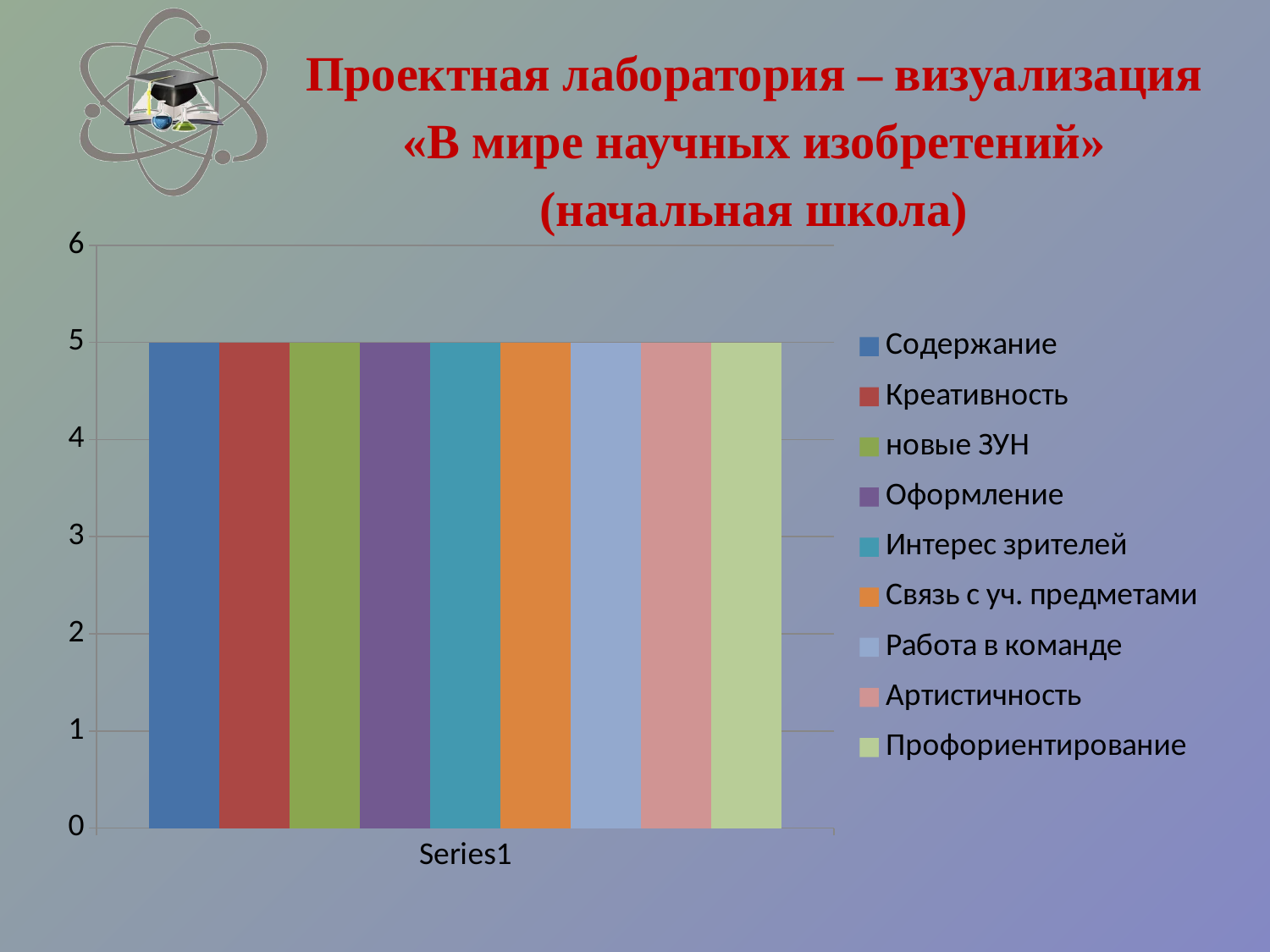
What is the highest value shown on the vertical axis? 6 How many bars are plotted in the chart? 9 What is the label on the horizontal axis? Series1 Is the value for Креативность greater or less than 4? greater Is the value for Артистичность greater or less than 6? less What kind of chart is shown on the slide? bar chart How many series does the legend list? 9 What is the value for Содержание? 5 What is the value for Работа в команде? 5 What is the difference between the values for Оформление and Интерес зрителей? 0 What is the value for Профориентирование? 5